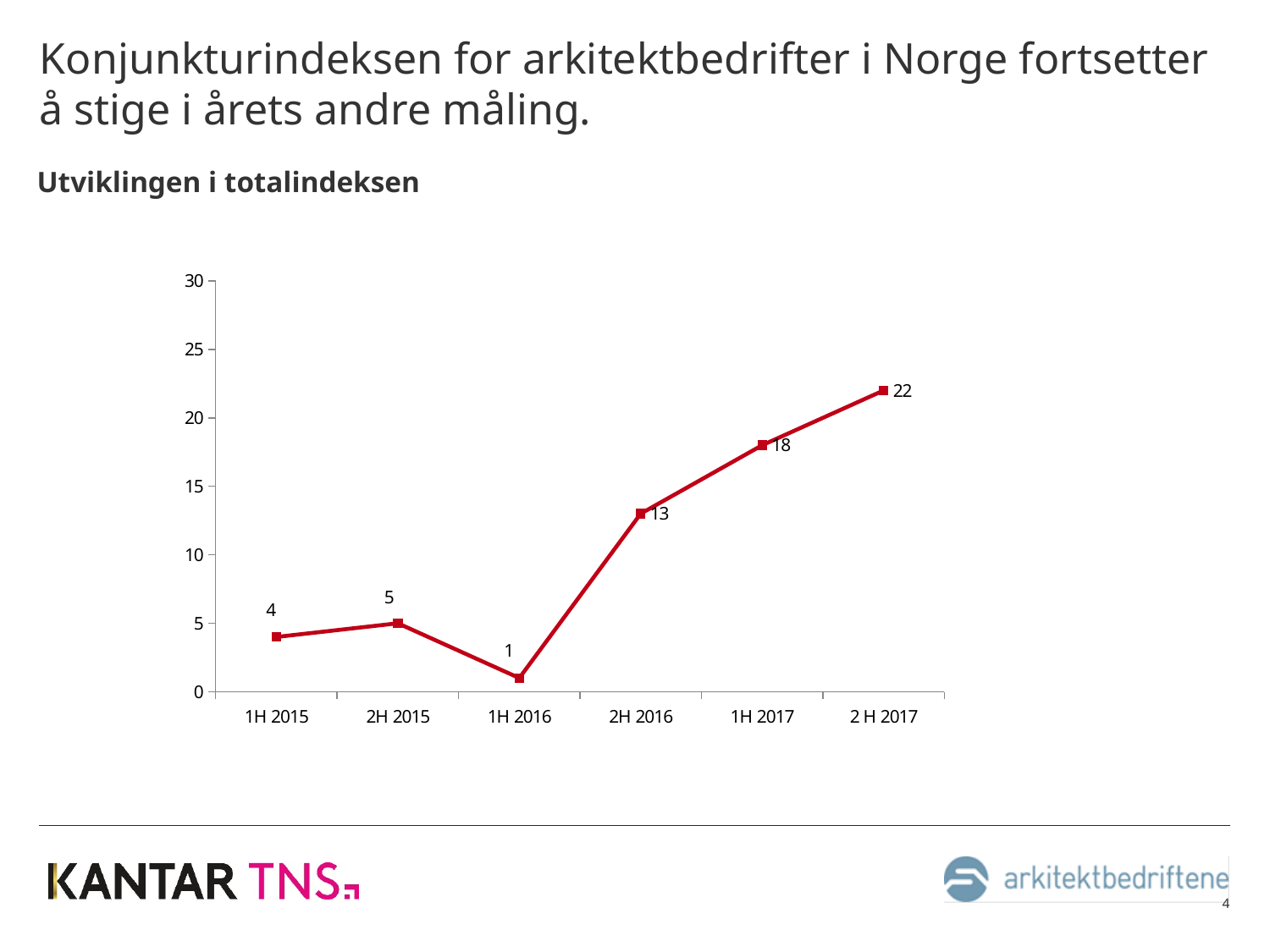
What is the difference between the values for 2 H 2017 and 1H 2017? 4 Which period has the lowest value of the total index? 1H 2016 What is the value of the total index for 2 H 2017? 22 What is the difference between the values for 2H 2016 and 1H 2016? 12 Which is larger, the value for 2H 2015 or the value for 1H 2016? 2H 2015 What is the value of the total index for 2H 2016? 13 What is the value of the total index for 1H 2016? 1 How many periods are plotted on the chart? 6 Do the values rise or fall from 1H 2016 to 2 H 2017? rise Which period has the highest value of the total index? 2 H 2017 What is the value of the total index for 1H 2015? 4 What kind of chart is shown on the slide? line chart